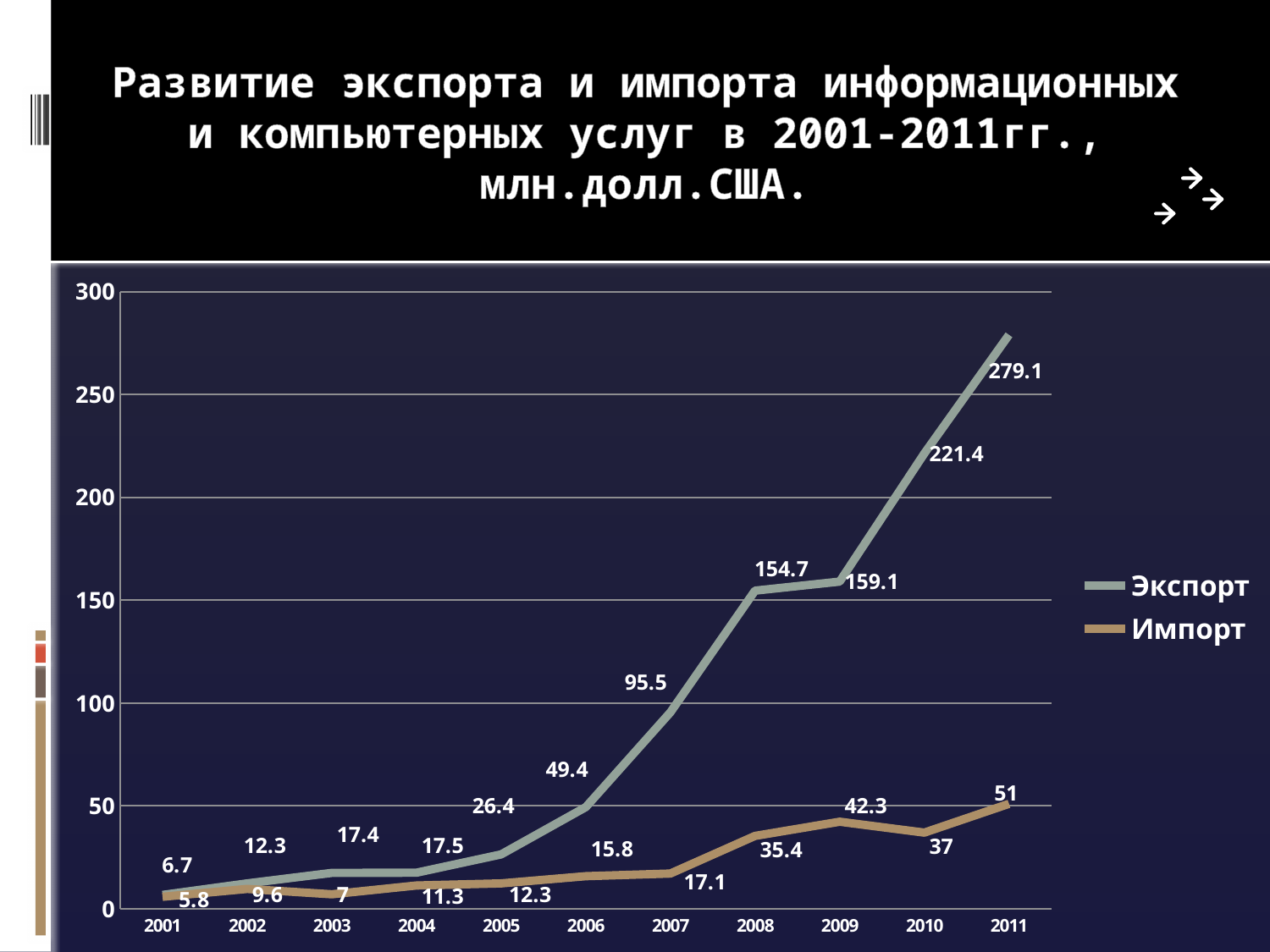
How many series does the legend list? 2 Does Экспорт generally rise or fall from 2001 to 2011? rise Which is larger in 2009: Экспорт or Импорт? Экспорт How many years are shown on the x axis? 11 What is the difference between Экспорт and Импорт in 2010? 184.4 In which year is Импорт lowest? 2001 What is the value of Экспорт in 2011? 279.1 What is the value of Импорт in 2008? 35.4 What is the value of Экспорт in 2007? 95.5 Is the value of Экспорт in 2008 greater or less than 150? greater In which year is Экспорт highest? 2011 What type of chart is shown on the slide? line chart